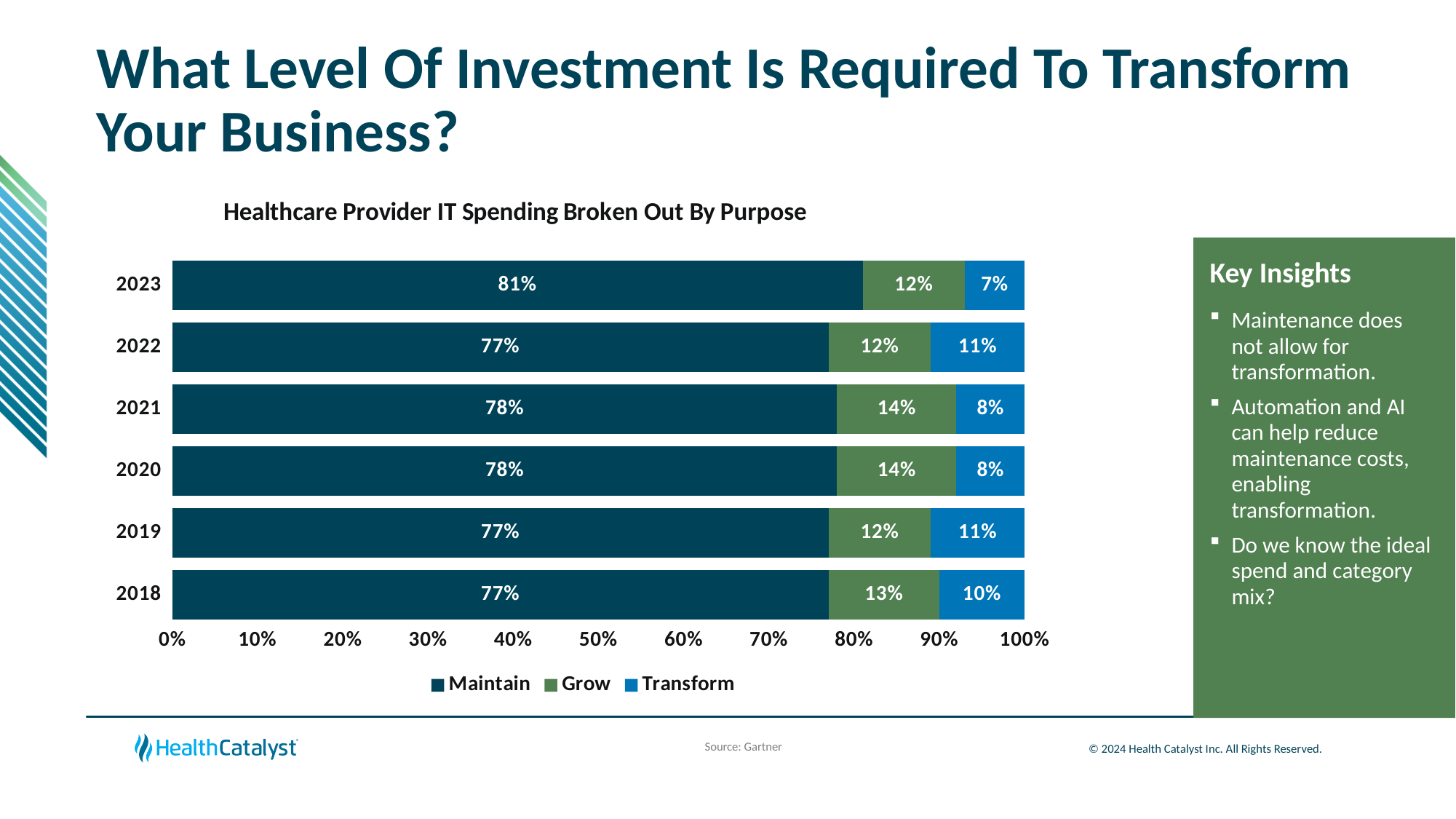
What is the difference between the Maintain values for 2023 and 2022? 4% Which year has the lowest Transform value? 2023 What kind of chart is shown on the slide? Stacked bar chart What is the title of the chart? Healthcare Provider IT Spending Broken Out By Purpose What is the Grow value for 2018? 13% Which year has the highest Maintain value? 2023 What is the Maintain value for 2023? 81% What is the total of the stacked bar for 2021? 100% How many series does the legend list? 3 Which is larger, the Transform value for 2019 or the Transform value for 2021? 2019 What is the Transform value for 2022? 11% How many years are shown on the chart? 6